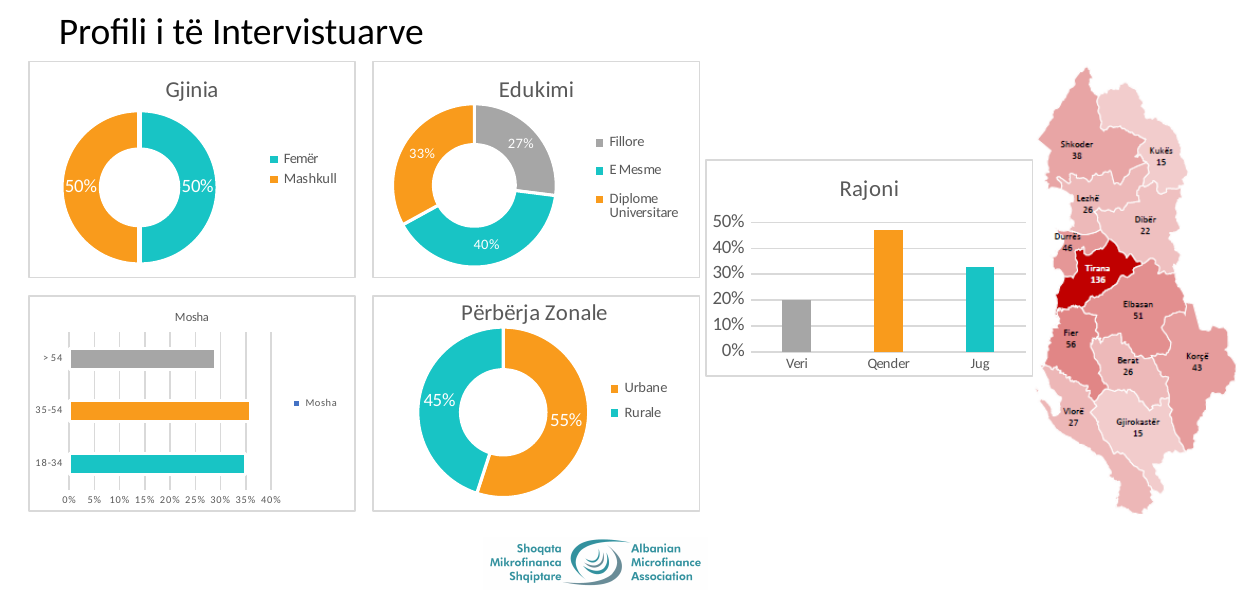
In the 'Gjinia' chart, what percentage is shown for Femër? 50% In the 'Mosha' chart, which age group has the lowest value? > 54 In the 'Edukimi' chart, how many categories does the legend list? 3 In the 'Përbërja Zonale' chart, what percentage is shown for Urbane? 55% In the 'Edukimi' chart, what percentage is shown for E Mesme? 40% In the 'Përbërja Zonale' chart, which is larger, Urbane or Rurale? Urbane In the 'Rajoni' chart, which region has the highest value? Qender In the 'Edukimi' chart, which category has the smallest share? Fillore What kind of chart is the 'Mosha' chart? bar chart In the 'Edukimi' chart, what is the difference between the E Mesme share and the Fillore share? 13% In the 'Rajoni' chart, is the value for Veri greater or less than 30%? less In the 'Rajoni' chart, is the value for Qender greater or less than 40%? greater